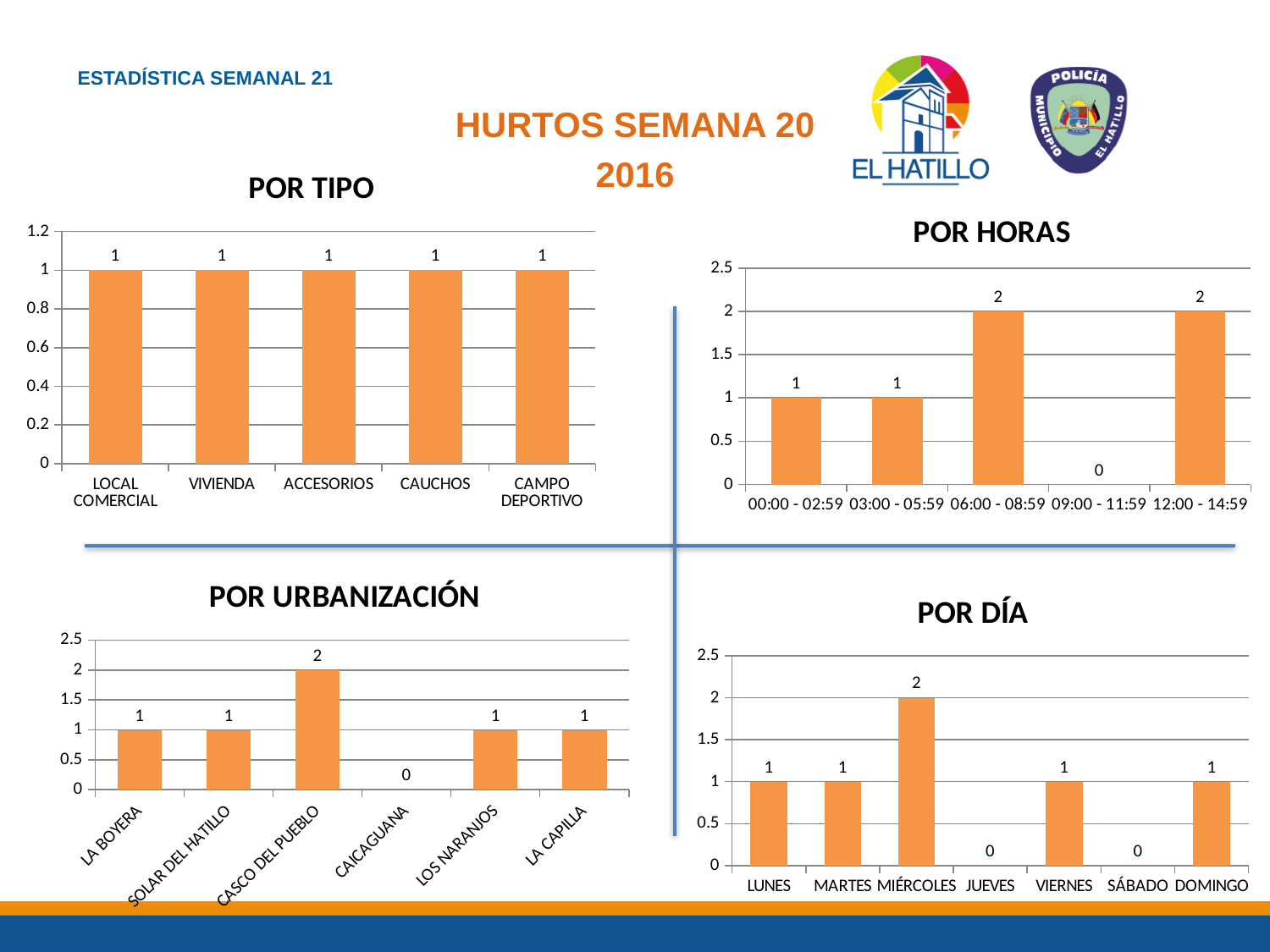
What kind of chart is the POR DÍA chart? Bar chart In the POR HORAS chart, what is the value for 06:00 - 08:59? 2 In the POR URBANIZACIÓN chart, how many categories are shown? 6 In the POR DÍA chart, what is the value for SÁBADO? 0 In the POR DÍA chart, is the value for MIÉRCOLES larger than the value for VIERNES? Yes In the POR TIPO chart, how many categories are shown? 5 In the POR TIPO chart, what is the value for VIVIENDA? 1 In the POR HORAS chart, what is the value for 09:00 - 11:59? 0 In the POR HORAS chart, what is the difference between the values for 12:00 - 14:59 and 03:00 - 05:59? 1 In the POR DÍA chart, which day has the highest value? MIÉRCOLES In the POR URBANIZACIÓN chart, which category has the lowest value? CAICAGUANA In the POR URBANIZACIÓN chart, which category has the highest value? CASCO DEL PUEBLO